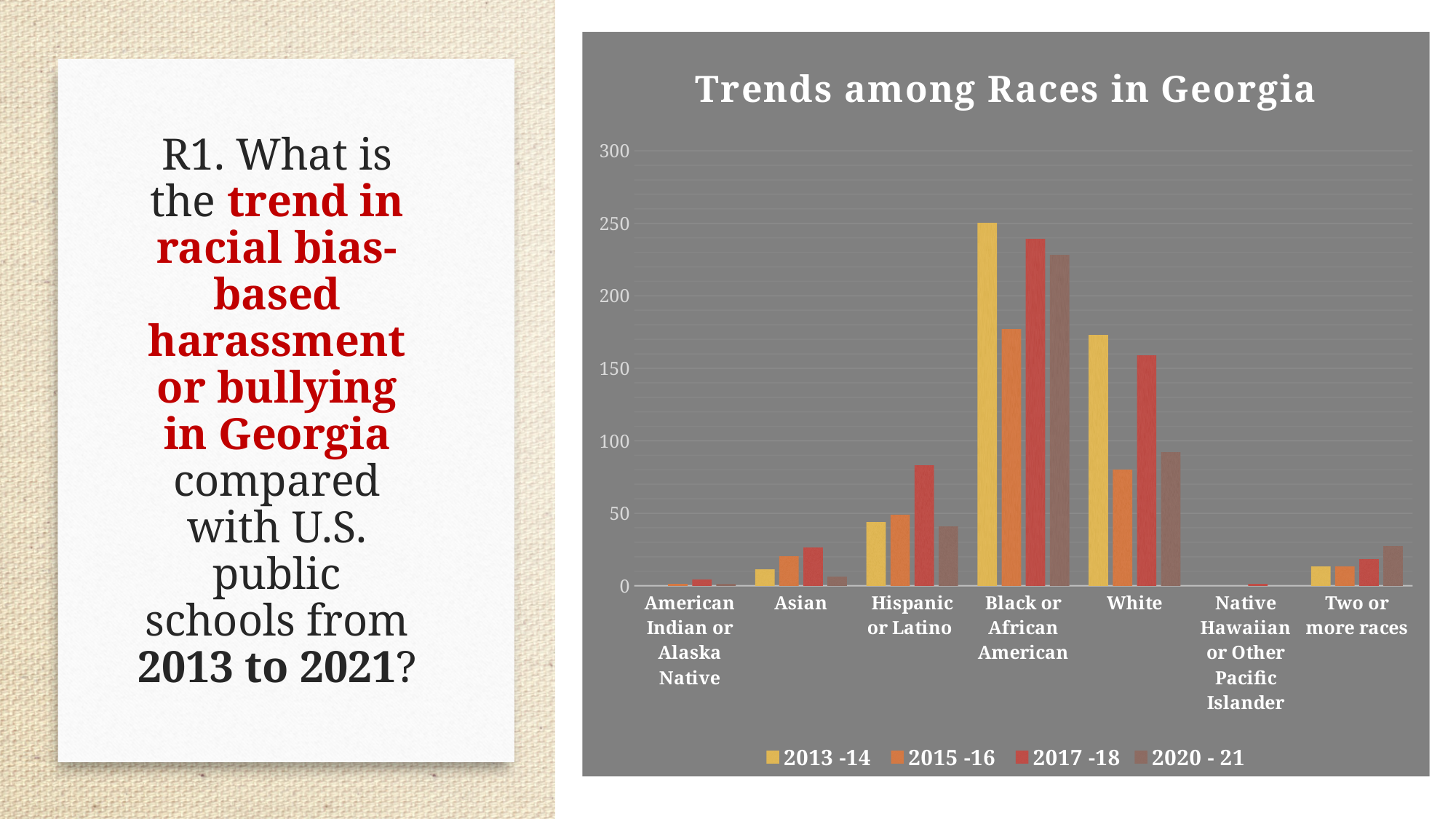
How many race categories are shown on the x axis of the chart? 7 For the White category, which is larger: the 2013 -14 value or the 2015 -16 value? 2013 -14 What is the title of the chart? Trends among Races in Georgia Is the 2015 -16 value for White greater or less than 100? less Is the 2013 -14 value for Black or African American greater or less than 200? greater How many series does the legend of the chart list? 4 Which race category has the highest value for 2013 -14? Black or African American For Two or more races, is the 2020 - 21 value greater or less than the 2013 -14 value? greater What kind of chart is shown on the slide? Bar chart Which race category has the lowest values across all years in the chart? Native Hawaiian or Other Pacific Islander For Hispanic or Latino, which is larger: the 2017 -18 value or the 2020 - 21 value? 2017 -18 Is the 2017 -18 value for Hispanic or Latino greater or less than 50? greater